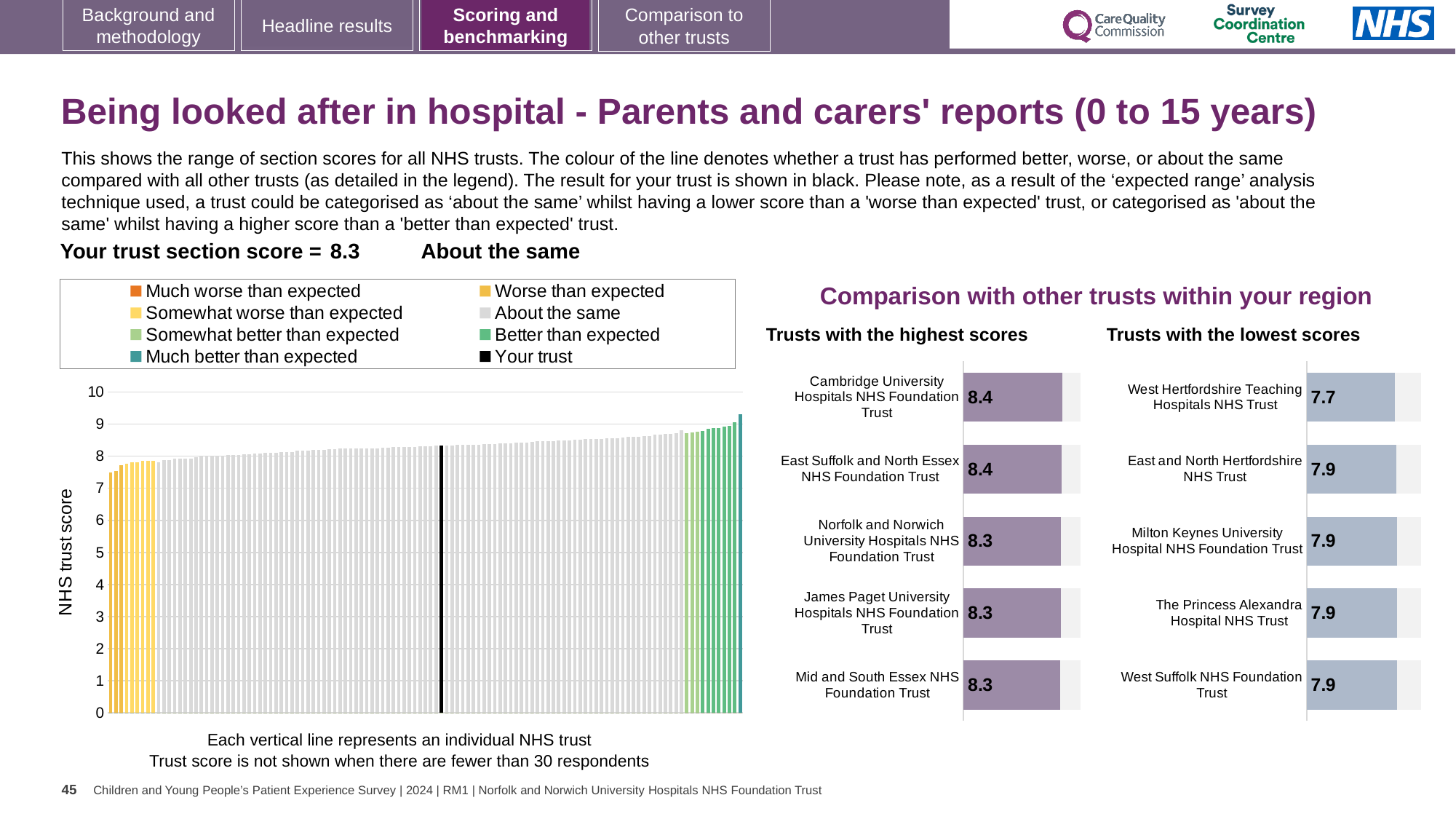
In the 'Trusts with the lowest scores' chart, what is the difference between the score for West Suffolk NHS Foundation Trust and the score for West Hertfordshire Teaching Hospitals NHS Trust? 0.2 In the 'Trusts with the lowest scores' chart, what is the score for West Hertfordshire Teaching Hospitals NHS Trust? 7.7 What kind of chart is the large 'NHS trust score' chart on the left of the slide? Bar chart How many trusts are shown in the 'Trusts with the lowest scores' chart? 5 In the 'Trusts with the highest scores' chart, what is the score for Mid and South Essex NHS Foundation Trust? 8.3 In the large 'NHS trust score' chart on the left, do the bar values rise or fall from left to right along the x axis? Rise Which is larger: the score for Cambridge University Hospitals NHS Foundation Trust in the 'Trusts with the highest scores' chart, or the score for West Hertfordshire Teaching Hospitals NHS Trust in the 'Trusts with the lowest scores' chart? Cambridge University Hospitals NHS Foundation Trust In the large 'NHS trust score' chart on the left, is the value of the black 'Your trust' bar greater or less than 8? greater In the 'Trusts with the lowest scores' chart, which trust has the lowest score? West Hertfordshire Teaching Hospitals NHS Trust How many trusts are shown in the 'Trusts with the highest scores' chart? 5 In the 'Trusts with the highest scores' chart, what is the score for Cambridge University Hospitals NHS Foundation Trust? 8.4 How many entries does the legend of the large 'NHS trust score' chart on the left list? 8